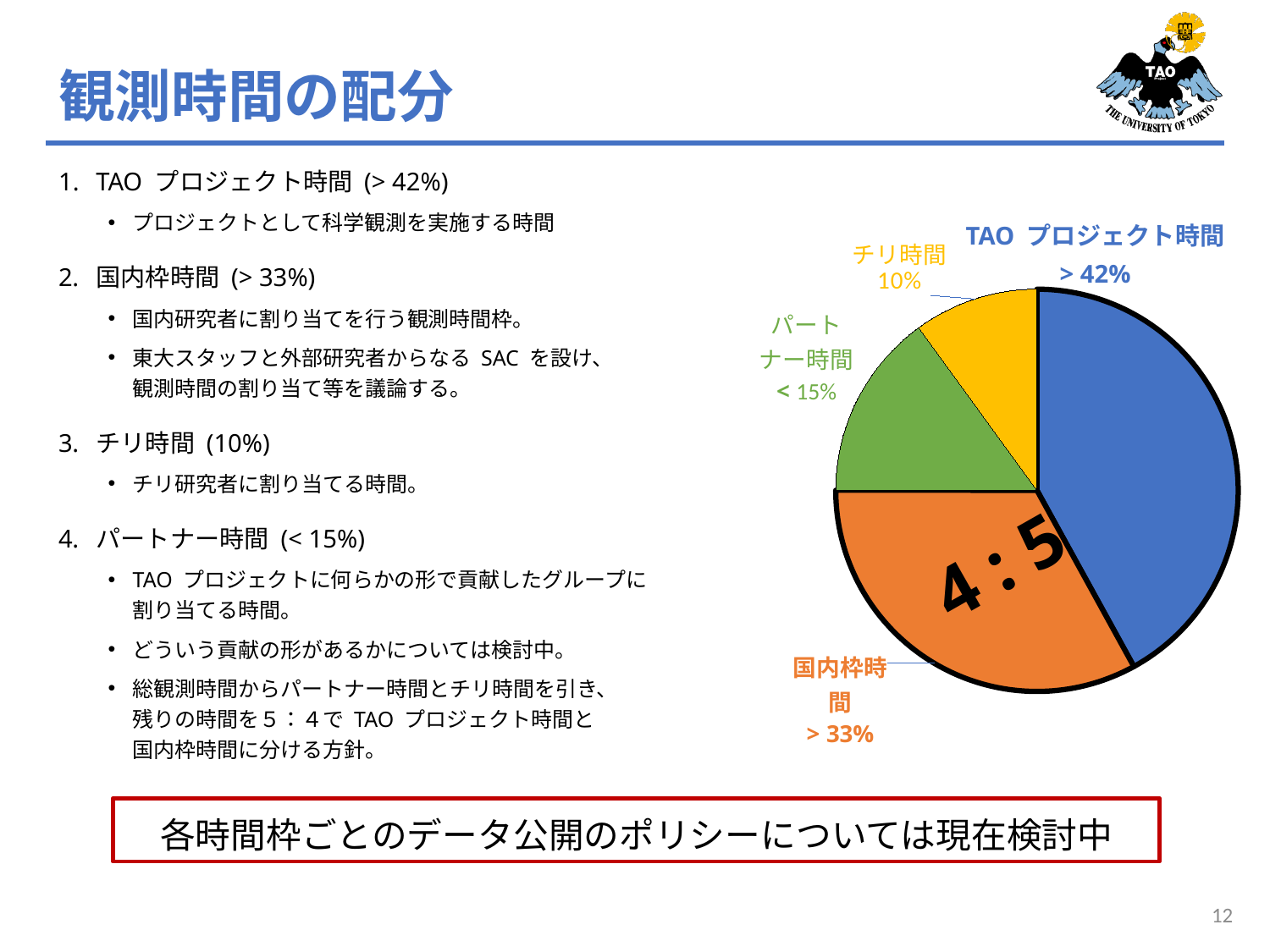
Which slice of the pie chart is the smallest? チリ時間 Which slice of the pie chart is the largest? TAO プロジェクト時間 Which slice is larger in the pie chart, 国内枠時間 or パートナー時間? 国内枠時間 Which slice is larger in the pie chart, TAO プロジェクト時間 or 国内枠時間? TAO プロジェクト時間 How many slices does the pie chart have? 4 What kind of chart is shown on the slide? pie chart What label is shown for the 国内枠時間 slice of the pie chart? > 33% What label is shown for the TAO プロジェクト時間 slice of the pie chart? > 42% What label is shown for the パートナー時間 slice of the pie chart? < 15% What colour is the TAO プロジェクト時間 slice of the pie chart? blue What ratio is written in large text over the pie chart? 4：5 What share of the pie chart is チリ時間? 10%